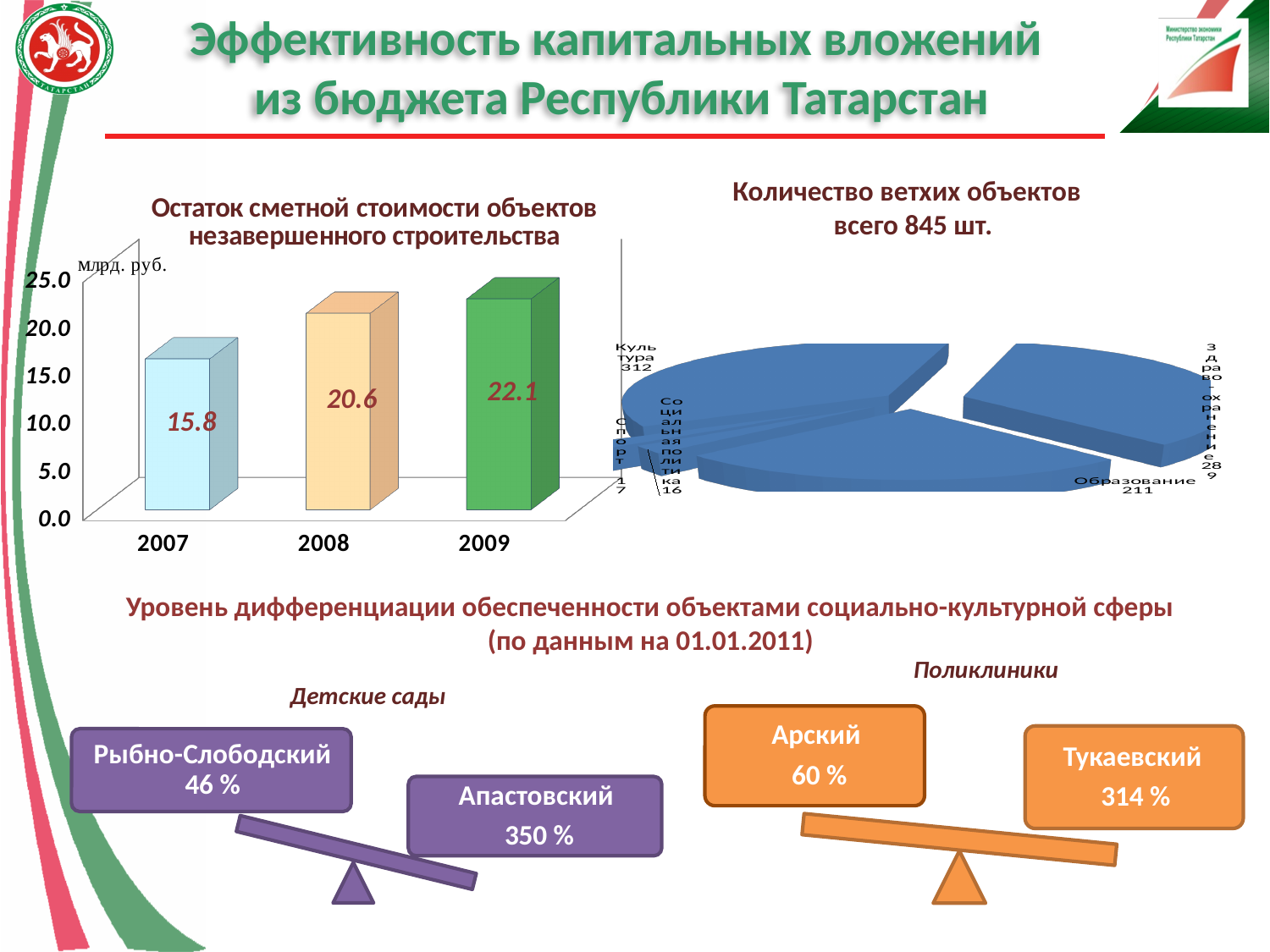
What unit is shown on the axis of the chart 'Остаток сметной стоимости объектов незавершенного строительства'? млрд. руб. In the chart 'Остаток сметной стоимости объектов незавершенного строительства', what is the difference between the 2009 and 2007 values? 6.3 In the chart 'Остаток сметной стоимости объектов незавершенного строительства', which year has the lowest value? 2007 In the pie chart 'Количество ветхих объектов всего 845 шт.', what is the value for Образование? 211 In the chart 'Остаток сметной стоимости объектов незавершенного строительства', what is the value for 2007? 15.8 In the pie chart 'Количество ветхих объектов всего 845 шт.', what is the value for Культура? 312 How many years are shown in the chart 'Остаток сметной стоимости объектов незавершенного строительства'? 3 In the chart 'Остаток сметной стоимости объектов незавершенного строительства', what is the value for 2008? 20.6 What kind of chart is 'Количество ветхих объектов всего 845 шт.'? pie chart In the chart 'Остаток сметной стоимости объектов незавершенного строительства', do the values rise or fall from 2007 to 2009? rise In the chart 'Остаток сметной стоимости объектов незавершенного строительства', which year has the highest value? 2009 What kind of chart is 'Остаток сметной стоимости объектов незавершенного строительства'? bar chart